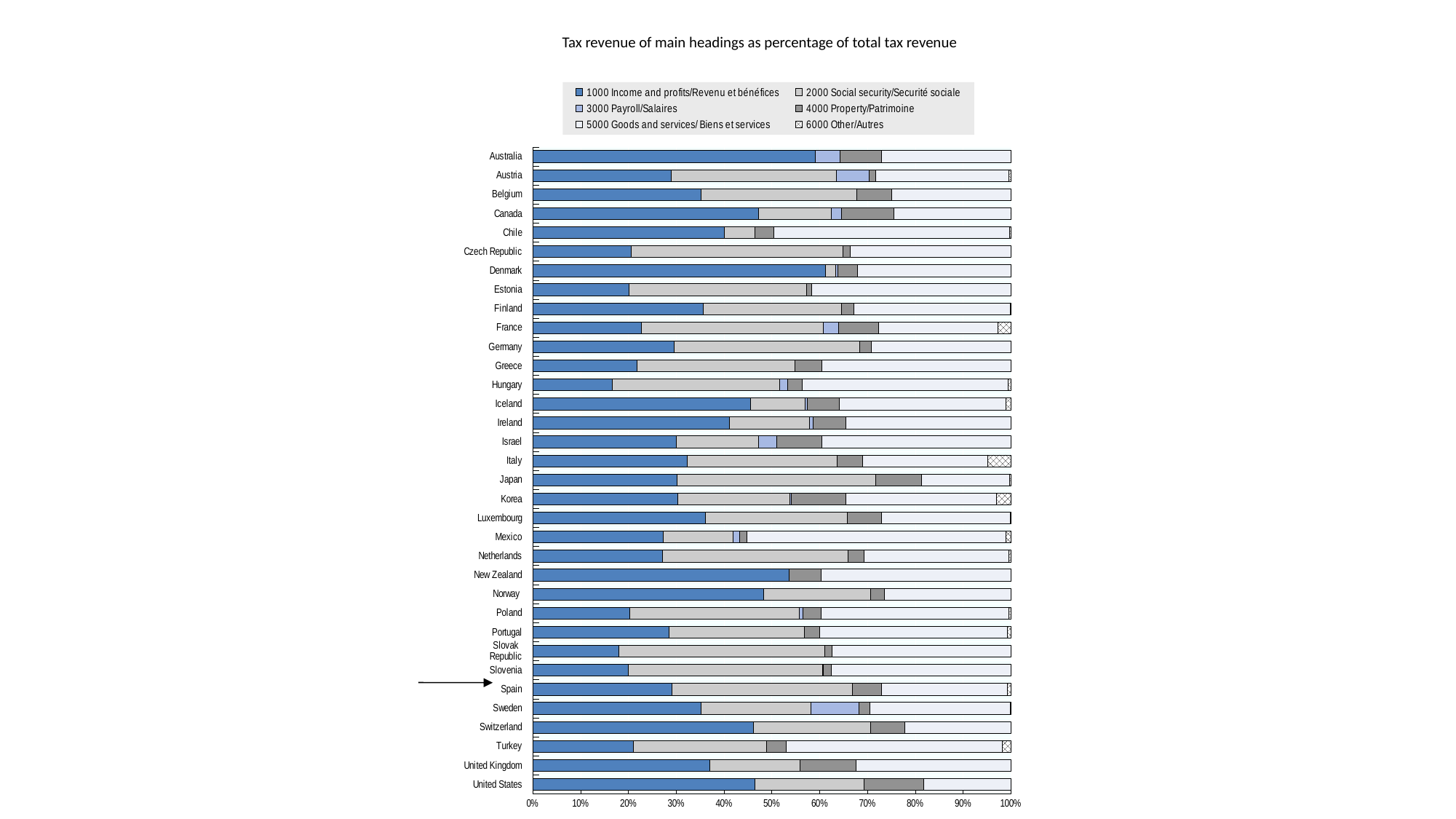
Which country does the arrow on the left of the chart point to? Spain What kind of chart is shown on the slide? stacked bar chart Is the value for Hungary's 1000 Income and profits share greater or less than 20%? less Is the value for New Zealand's 1000 Income and profits share greater or less than 50%? greater What is the title of the chart? Tax revenue of main headings as percentage of total tax revenue Is the value for the Slovak Republic's 1000 Income and profits share greater or less than 20%? less Which has a larger 1000 Income and profits share, Hungary or Denmark? Denmark Which has a larger 1000 Income and profits share, Australia or Japan? Australia How many series does the legend list? 6 How many countries are plotted on the chart? 34